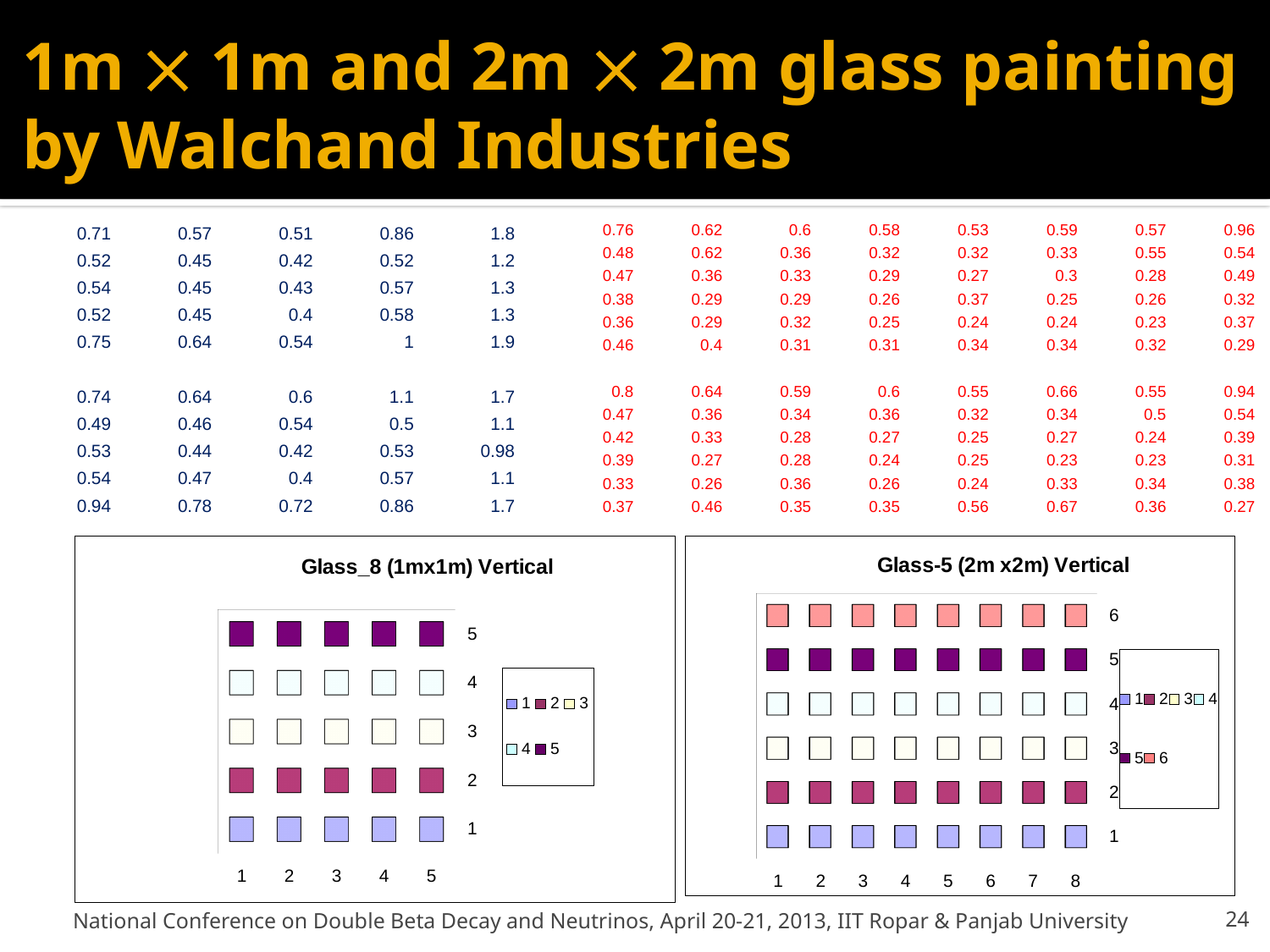
In the Glass_8 (1mx1m) Vertical chart, how many markers are plotted in total? 25 In the Glass_8 (1mx1m) Vertical chart, how many positions are labelled on the x axis? 5 In the Glass-5 (2m x2m) Vertical chart, how many markers are plotted for series 6? 8 Which chart has more series in its legend, Glass_8 (1mx1m) Vertical or Glass-5 (2m x2m) Vertical? Glass-5 (2m x2m) Vertical In the Glass-5 (2m x2m) Vertical chart, how many series does the legend list? 6 What kind of chart is the Glass_8 (1mx1m) Vertical chart? scatter chart In the Glass_8 (1mx1m) Vertical chart, how many series does the legend list? 5 What is the title of the chart on the right of the slide? Glass-5 (2m x2m) Vertical What is the title of the chart on the left of the slide? Glass_8 (1mx1m) Vertical